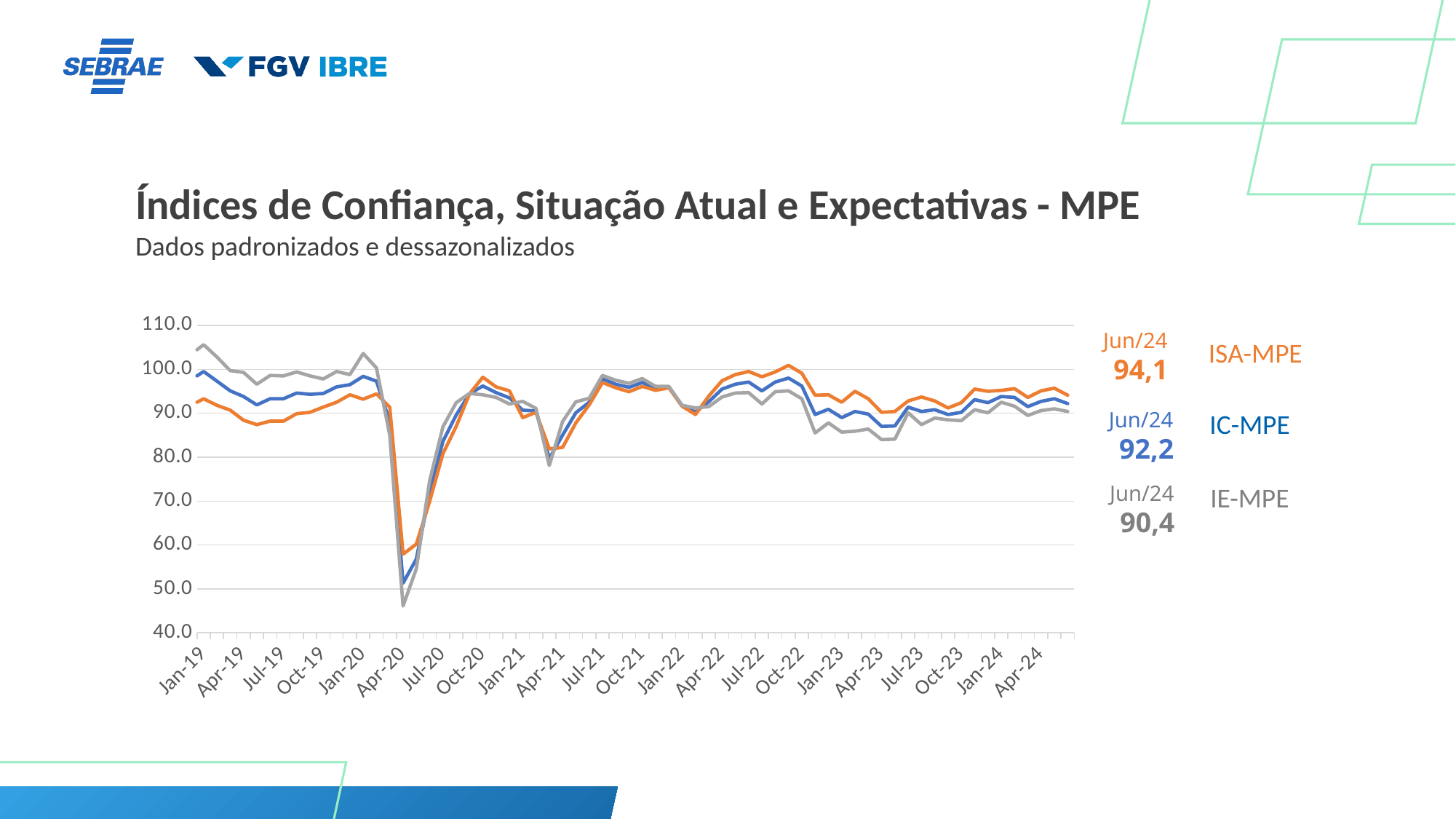
Which index has the highest value in Jun/24? ISA-MPE What is the value of ISA-MPE for Jun/24? 94,1 Between Jan-20 and Apr-20, do the three lines rise or fall? fall What kind of chart is shown on the slide? line chart What is the difference between the ISA-MPE and IE-MPE values for Jun/24? 3,7 Which index has the lowest value in Jun/24? IE-MPE Is the lowest point of the IE-MPE (gray) line, around Apr-20, greater or less than 50.0? less What is the value of IC-MPE for Jun/24? 92,2 What is the value of IE-MPE for Jun/24? 90,4 What colour is the ISA-MPE line? orange How many series does the chart show? 3 Which is larger in Jun/24, IC-MPE or IE-MPE? IC-MPE